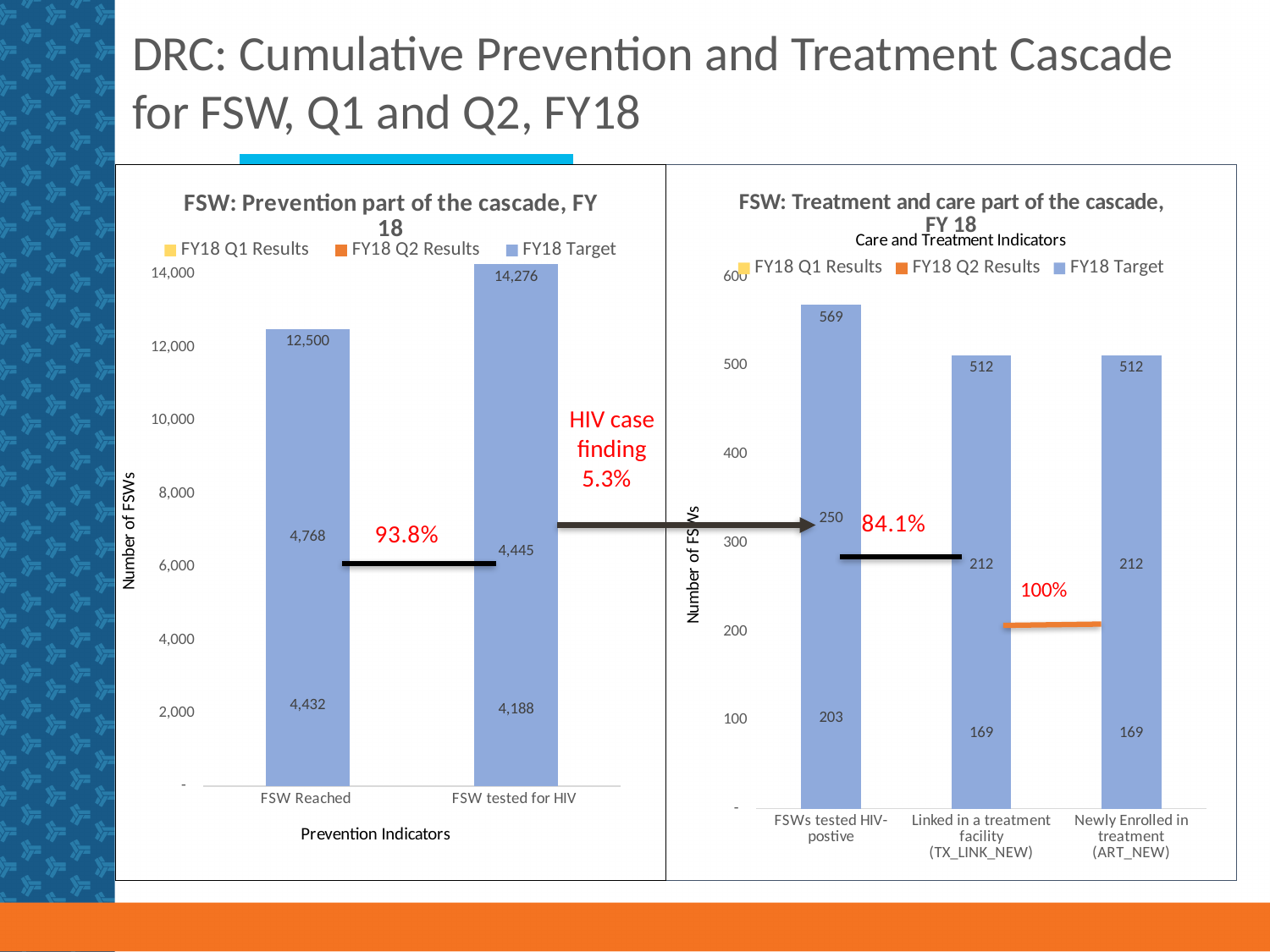
In the left chart, 'FSW: Prevention part of the cascade, FY 18', how many series does the legend list? 3 In the left chart, 'FSW: Prevention part of the cascade, FY 18', which category has the larger FY18 Target, FSW Reached or FSW tested for HIV? FSW tested for HIV In the right chart, 'FSW: Treatment and care part of the cascade, FY 18', what is the difference between the FY18 Target for FSWs tested HIV-positive and the FY18 Target for Linked in a treatment facility (TX_LINK_NEW)? 57 In the right chart, 'FSW: Treatment and care part of the cascade, FY 18', how many categories are shown on the x axis? 3 What type of chart is the left chart, 'FSW: Prevention part of the cascade, FY 18'? bar chart In the left chart, 'FSW: Prevention part of the cascade, FY 18', what is the difference between the FY18 Target for FSW tested for HIV and the FY18 Target for FSW Reached? 1,776 In the left chart, 'FSW: Prevention part of the cascade, FY 18', what percentage is annotated between the FSW Reached and FSW tested for HIV bars? 93.8% In the right chart, 'FSW: Treatment and care part of the cascade, FY 18', what is the FY18 Target for Newly Enrolled in treatment (ART_NEW)? 512 In the right chart, 'FSW: Treatment and care part of the cascade, FY 18', what is the FY18 Target for FSWs tested HIV-positive? 569 In the right chart, 'FSW: Treatment and care part of the cascade, FY 18', which category has the highest FY18 Target? FSWs tested HIV-positive In the left chart, 'FSW: Prevention part of the cascade, FY 18', what is the FY18 Target for FSW tested for HIV? 14,276 In the left chart, 'FSW: Prevention part of the cascade, FY 18', what is the FY18 Target for FSW Reached? 12,500